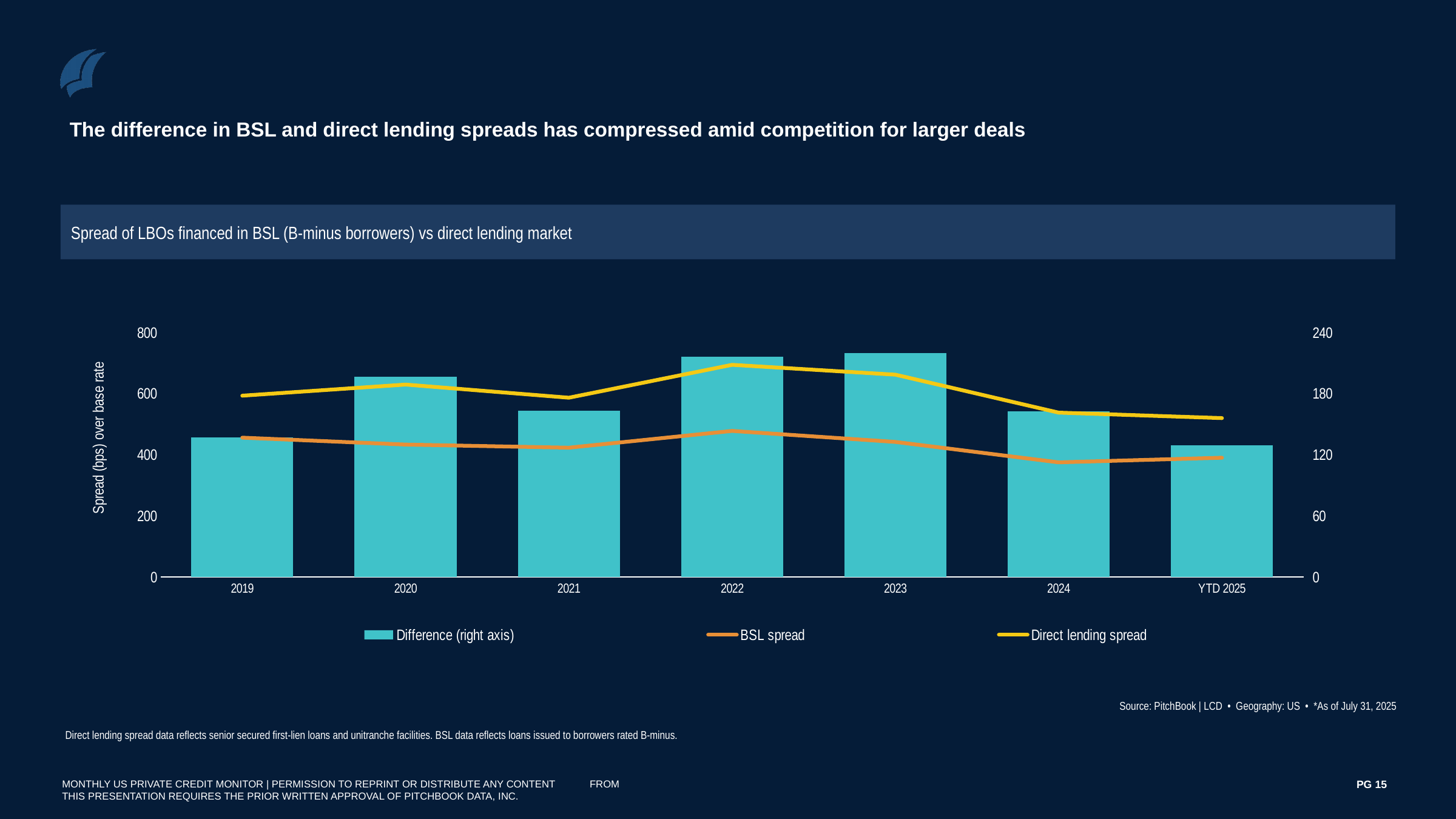
Which series is plotted as bars? Difference (right axis) Is the BSL spread in 2024 greater or less than 400? less What is the label of the left vertical axis? Spread (bps) over base rate In which year is the Direct lending spread highest? 2022 In which period is the Direct lending spread lowest? YTD 2025 How many time periods are shown on the x axis? 7 Does the Direct lending spread rise or fall from 2023 to YTD 2025? fall Is the Difference value for 2023 on the right axis greater or less than 180? greater What kind of chart is shown on the slide? A combined bar and line chart In which period is the Difference bar lowest? YTD 2025 How many series does the legend list? 3 Is the Direct lending spread in 2022 greater or less than 600? greater